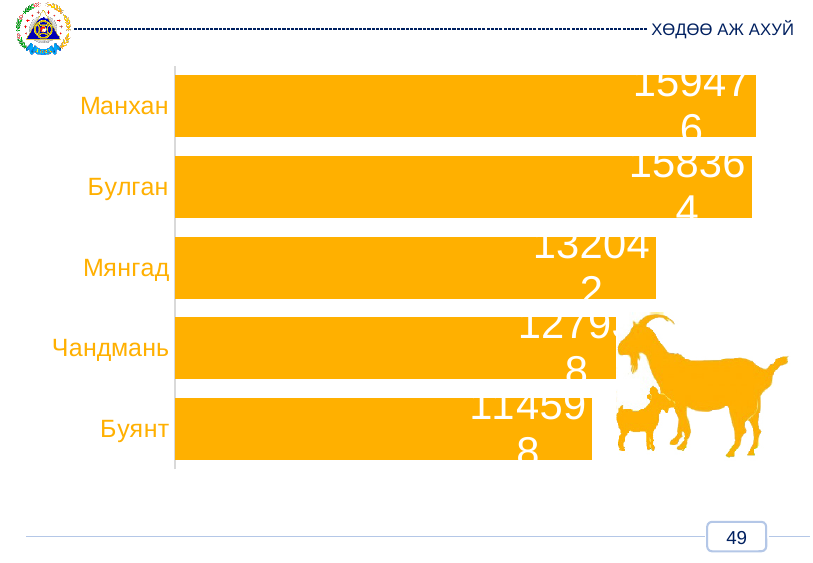
Which is larger, the value for Мянгад or the value for Буянт? Мянгад Which category has the lowest value? Буянт What is the value for Манхан? 159476 What colour are the bars in the chart? orange Which category has the highest value? Манхан What is the value for Булган? 158364 What is the value for Мянгад? 132042 What is the difference between the values for Манхан and Булган? 1112 What kind of chart is shown on the slide? bar chart How many categories are shown in the chart? 5 What is the value for Буянт? 114598 What is the difference between the values for Мянгад and Буянт? 17444